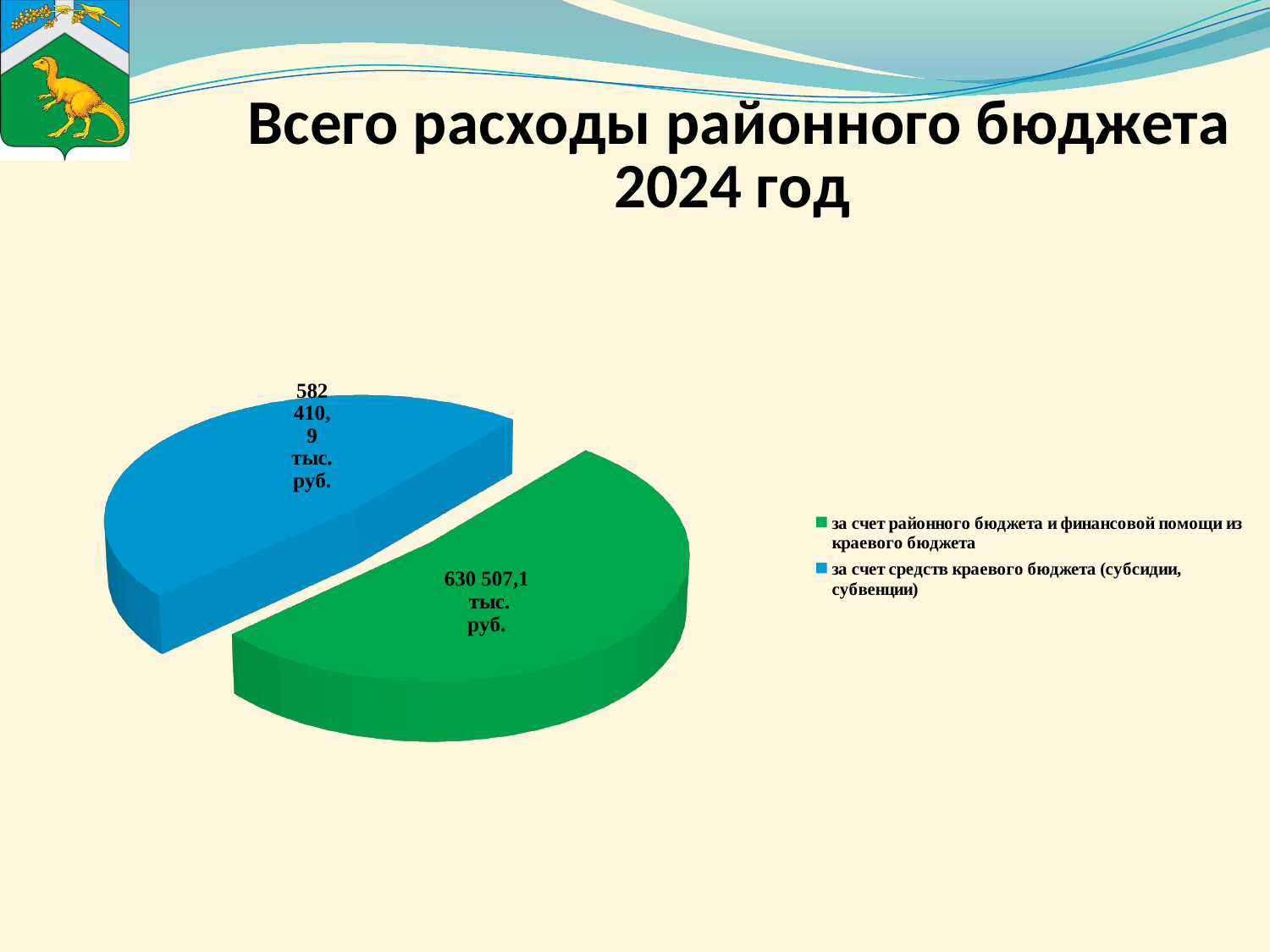
How many slices does the pie chart have? 2 What is the total of the two slices shown in the pie chart? 1 212 918,0 тыс. руб. Which is larger: the expenditure from the district budget and financial aid from the regional budget, or the expenditure from regional budget funds (subsidies, subventions)? за счет районного бюджета и финансовой помощи из краевого бюджета What kind of chart is shown on the slide? Pie chart Which category has the largest slice in the pie chart? за счет районного бюджета и финансовой помощи из краевого бюджета What is the value of the slice for 'за счет районного бюджета и финансовой помощи из краевого бюджета'? 630 507,1 тыс. руб. What is the title of the slide containing the pie chart? Всего расходы районного бюджета 2024 год What colour is the slice for 'за счет средств краевого бюджета (субсидии, субвенции)'? Blue What is the difference between the two slices of the pie chart, in тыс. руб.? 48 096,2 тыс. руб. How many entries does the legend list? 2 Which category has the smallest slice in the pie chart? за счет средств краевого бюджета (субсидии, субвенции) What is the value of the slice for 'за счет средств краевого бюджета (субсидии, субвенции)'? 582 410,9 тыс. руб.